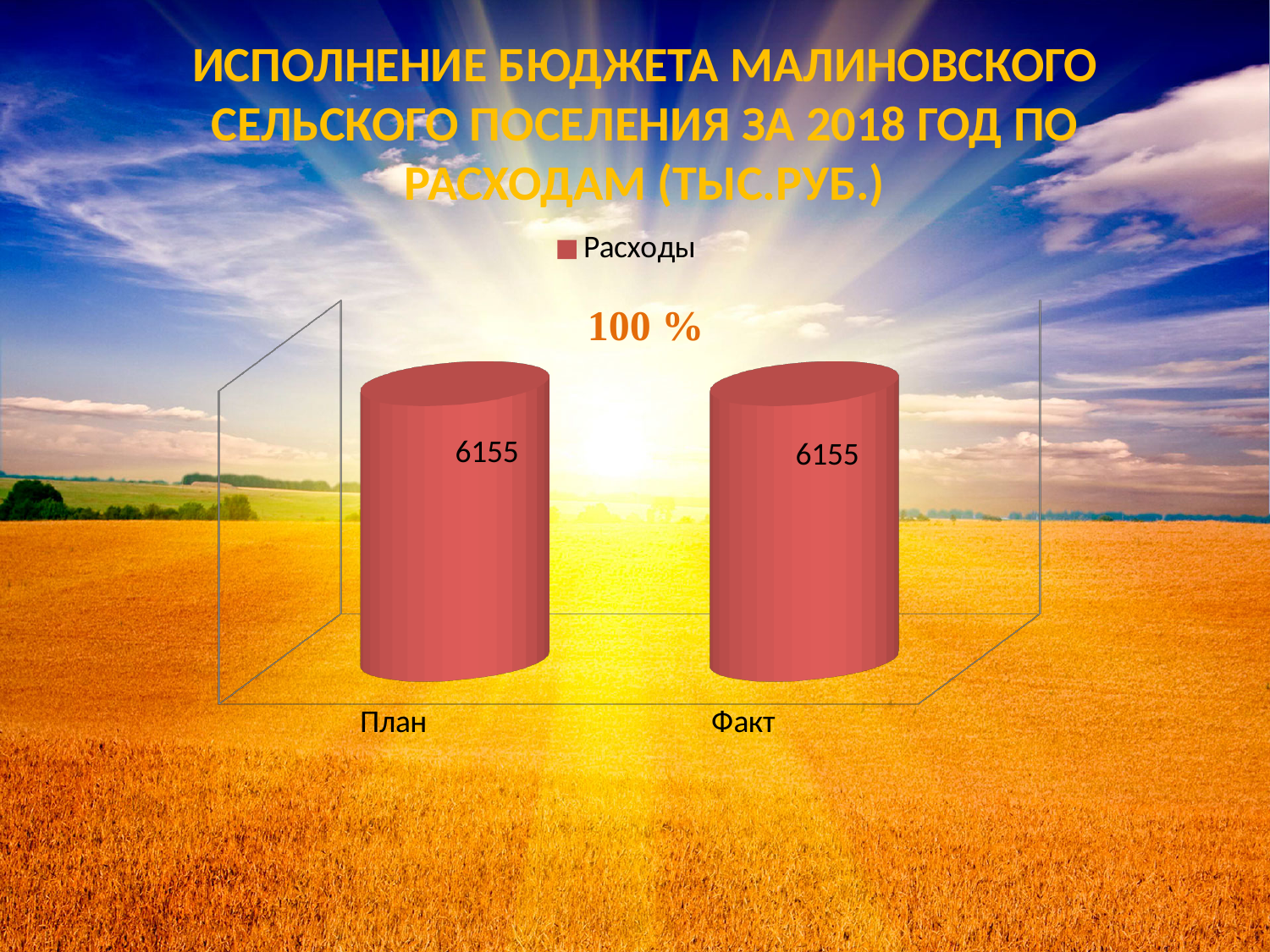
What percentage is printed above the bars? 100 % How many categories are shown on the x axis? 2 What is the difference between the values for План and Факт? 0 What is the total of the values for План and Факт? 12310 What is the value for Факт? 6155 What kind of chart is shown on the slide? bar chart What series name is listed in the legend? Расходы Is the value for Факт greater than, less than, or equal to the value for План? equal What is the value for План? 6155 How many series does the legend list? 1